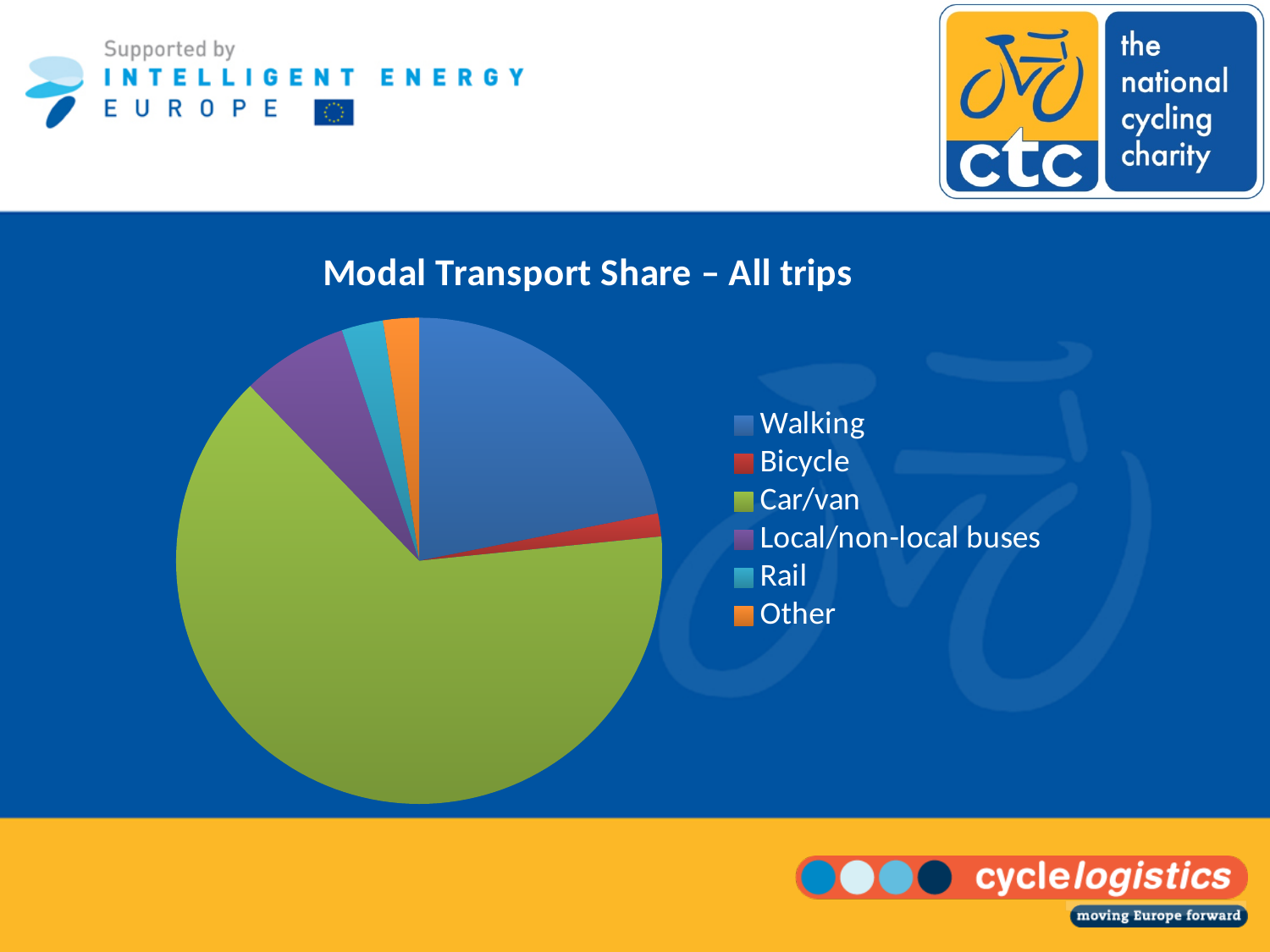
Which category is shown in red in the pie chart? Bicycle Which is larger, the share for Walking or the share for Local/non-local buses? Walking Which category has the largest share of the pie? Car/van What kind of chart is shown on the slide? Pie chart Which is larger, the share for Bicycle or the share for Walking? Walking What colour represents Car/van in the pie chart? Green Which is larger, the share for Walking or the share for Car/van? Car/van How many categories does the pie chart show? 6 What is the title of the chart? Modal Transport Share – All trips